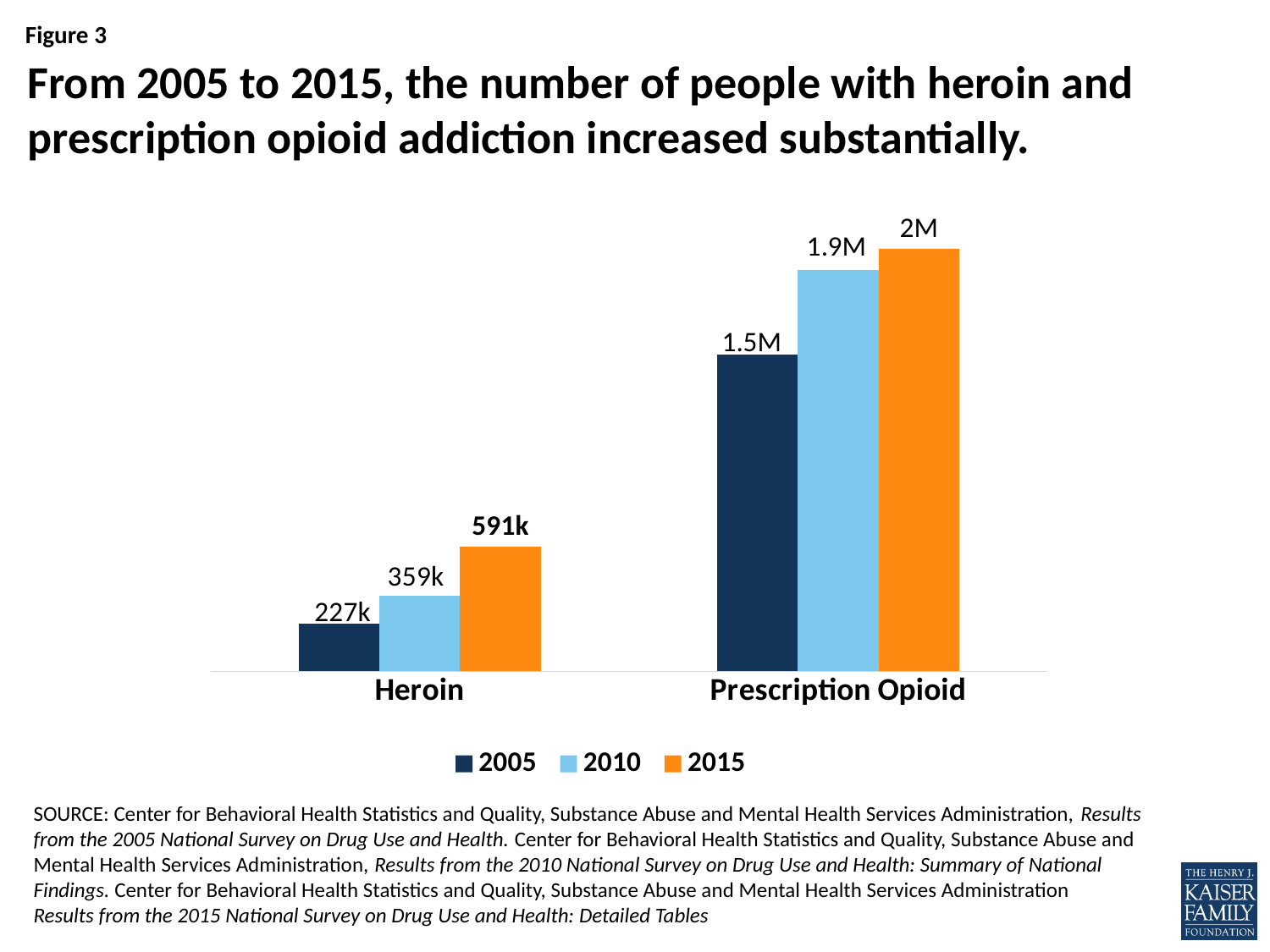
Which is larger, the Heroin value for 2010 or the Heroin value for 2015? 2015 Which year has the highest value for Heroin? 2015 What is the value for Heroin in 2015? 591k Do the Prescription Opioid values rise or fall from 2005 to 2015? Rise What is the difference between the Heroin values for 2015 and 2005? 364k What is the value for Heroin in 2005? 227k What is the value for Prescription Opioid in 2015? 2M How many categories are shown on the x axis? 2 What kind of chart is shown on the slide? Bar chart What is the value for Prescription Opioid in 2010? 1.9M Which year has the lowest value for Prescription Opioid? 2005 How many series does the legend list? 3